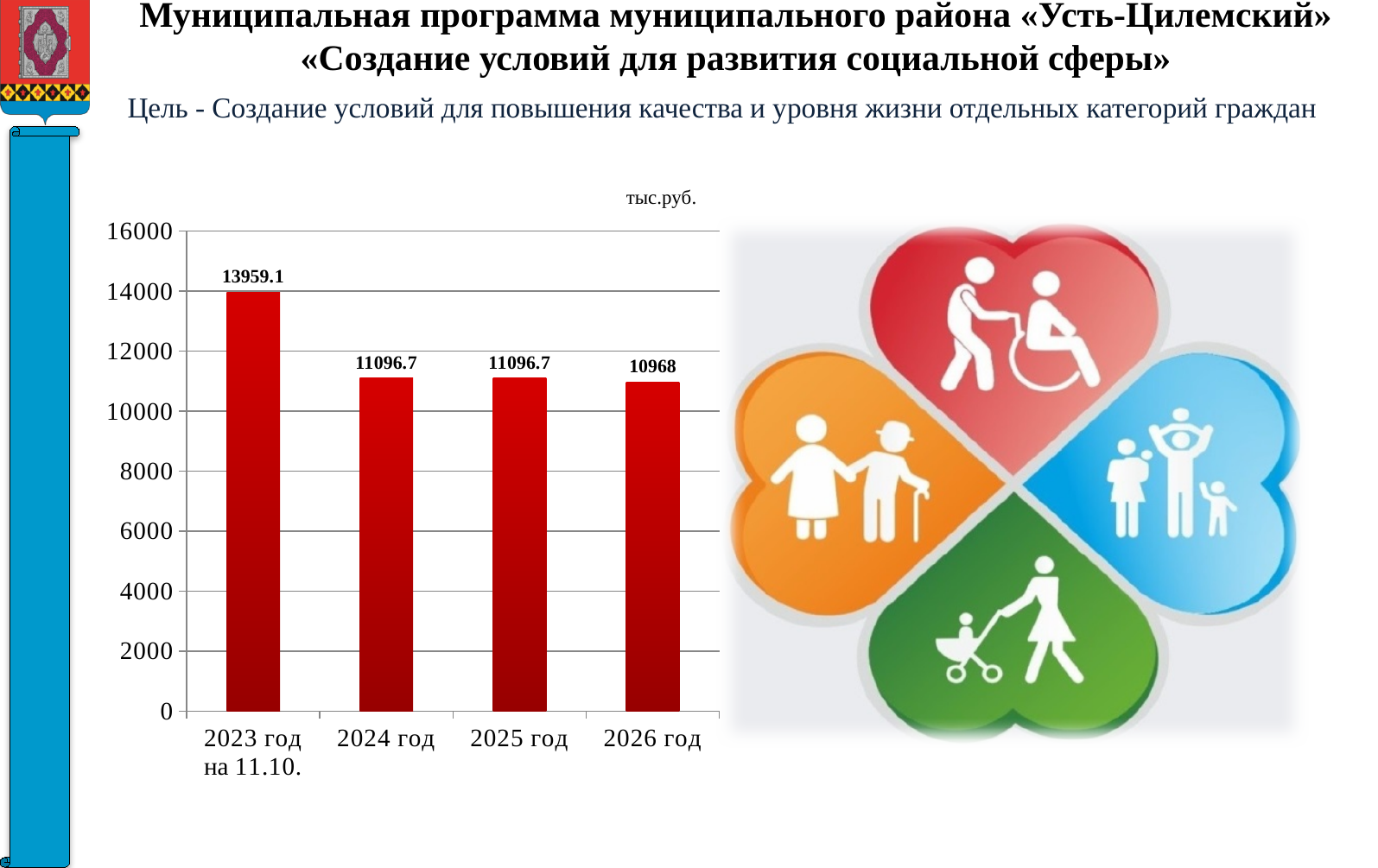
Is the value for 2025 год greater or less than 12000? less What unit label is shown above the chart? тыс.руб. What is the value for 2026 год? 10968 How many categories are shown on the x axis? 4 What is the difference between the values for 2025 год and 2026 год? 128.7 Which category has the lowest value? 2026 год What kind of chart is shown on the slide? bar chart Which is larger, the value for 2023 год на 11.10. or the value for 2026 год? 2023 год на 11.10. What is the value for 2024 год? 11096.7 Which category has the highest value? 2023 год на 11.10. What is the difference between the values for 2023 год на 11.10. and 2024 год? 2862.4 What is the value for 2023 год на 11.10.? 13959.1